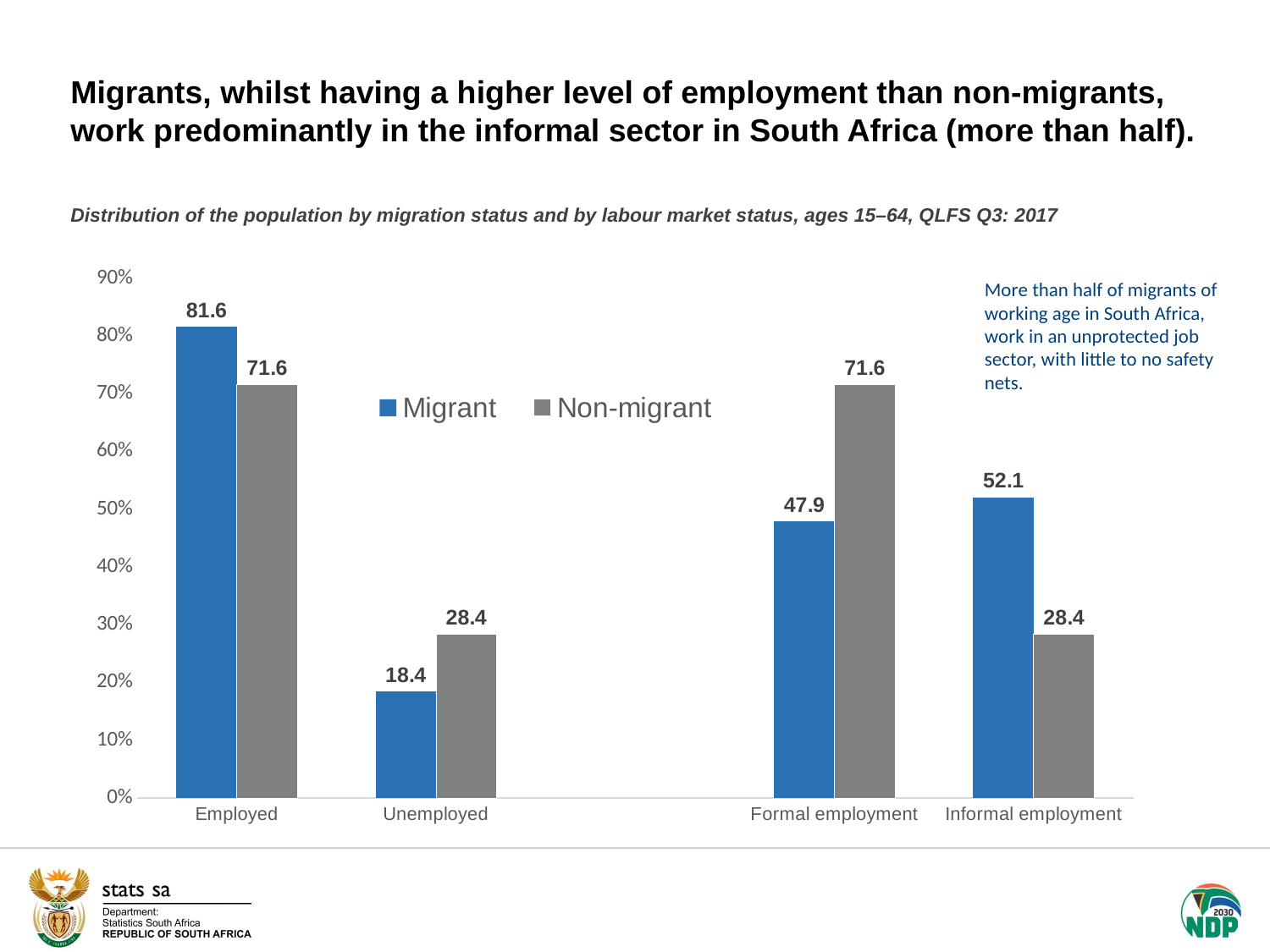
What is the Non-migrant value for Unemployed? 28.4 How many series does the legend list? 2 What is the difference between the Migrant and Non-migrant values for Formal employment? 23.7 Which is larger for Informal employment, the Migrant value or the Non-migrant value? Migrant What is the Migrant value for Informal employment? 52.1 What colour are the Non-migrant bars? Grey What is the Non-migrant value for Formal employment? 71.6 How many categories are shown on the x axis? 4 What kind of chart is shown on the slide? Bar chart Which category has the lowest Migrant value? Unemployed What is the Migrant value for Employed? 81.6 Which category has the highest Migrant value? Employed